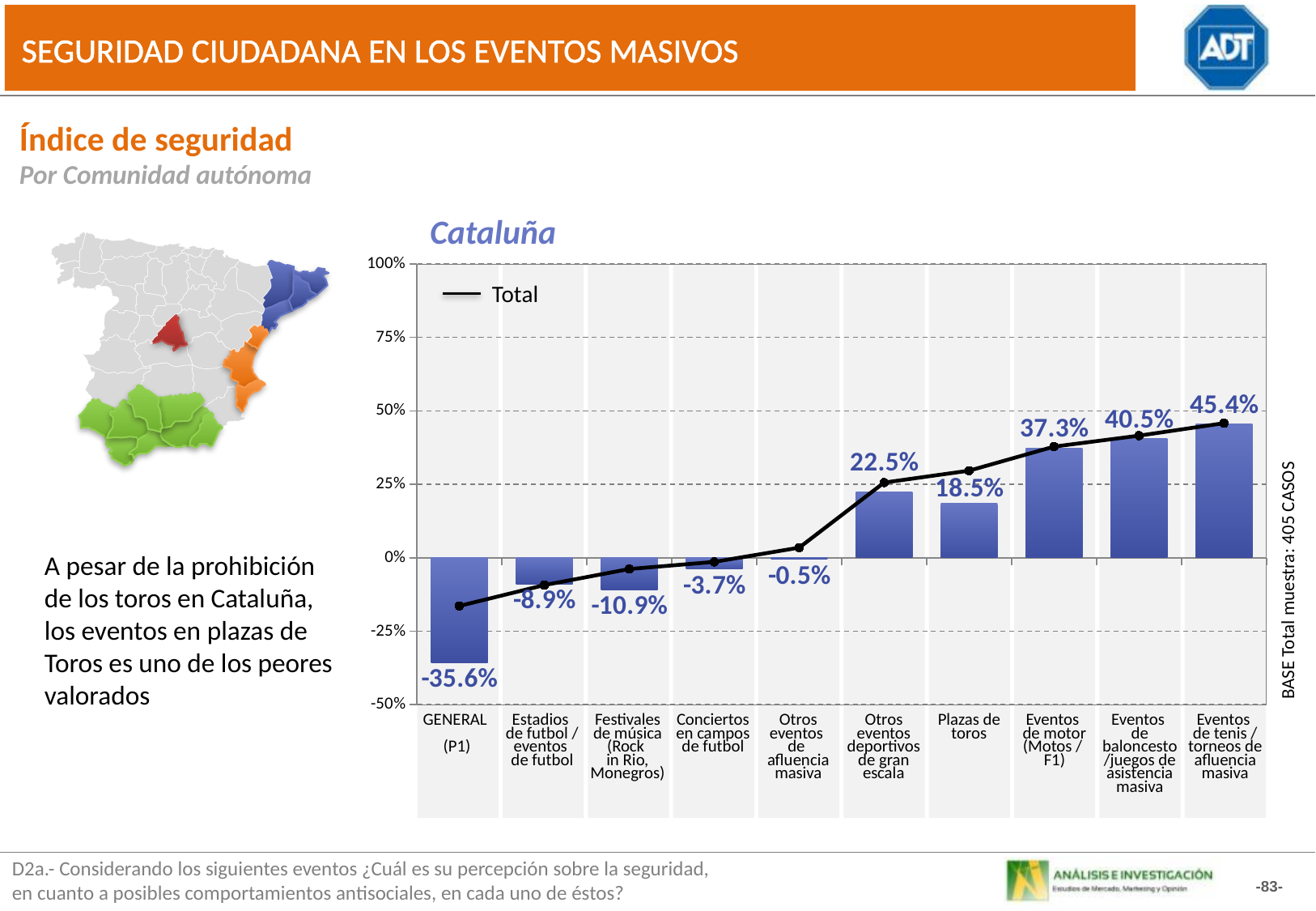
What is the value for Plazas de toros in the Cataluña chart? 18.5% What is the value for GENERAL (P1) in the Cataluña chart? -35.6% Is the value for Eventos de motor (Motos / F1) in the Cataluña chart greater or less than 25%? greater Which category has the highest value in the Cataluña chart? Eventos de tenis / torneos de afluencia masiva What is the value for Otros eventos de afluencia masiva in the Cataluña chart? -0.5% Which has a higher value in the Cataluña chart: Otros eventos deportivos de gran escala or Plazas de toros? Otros eventos deportivos de gran escala What is the difference between the values for Eventos de tenis / torneos de afluencia masiva and Eventos de baloncesto /juegos de asistencia masiva in the Cataluña chart? 4.9 percentage points What is the value for Eventos de motor (Motos / F1) in the Cataluña chart? 37.3% What kind of chart is used for the Cataluña data? Bar chart with a line overlay Which category has the lowest value in the Cataluña chart? GENERAL (P1) How many series does the legend of the Cataluña chart list? 1 How many categories are shown on the x axis of the Cataluña chart? 10